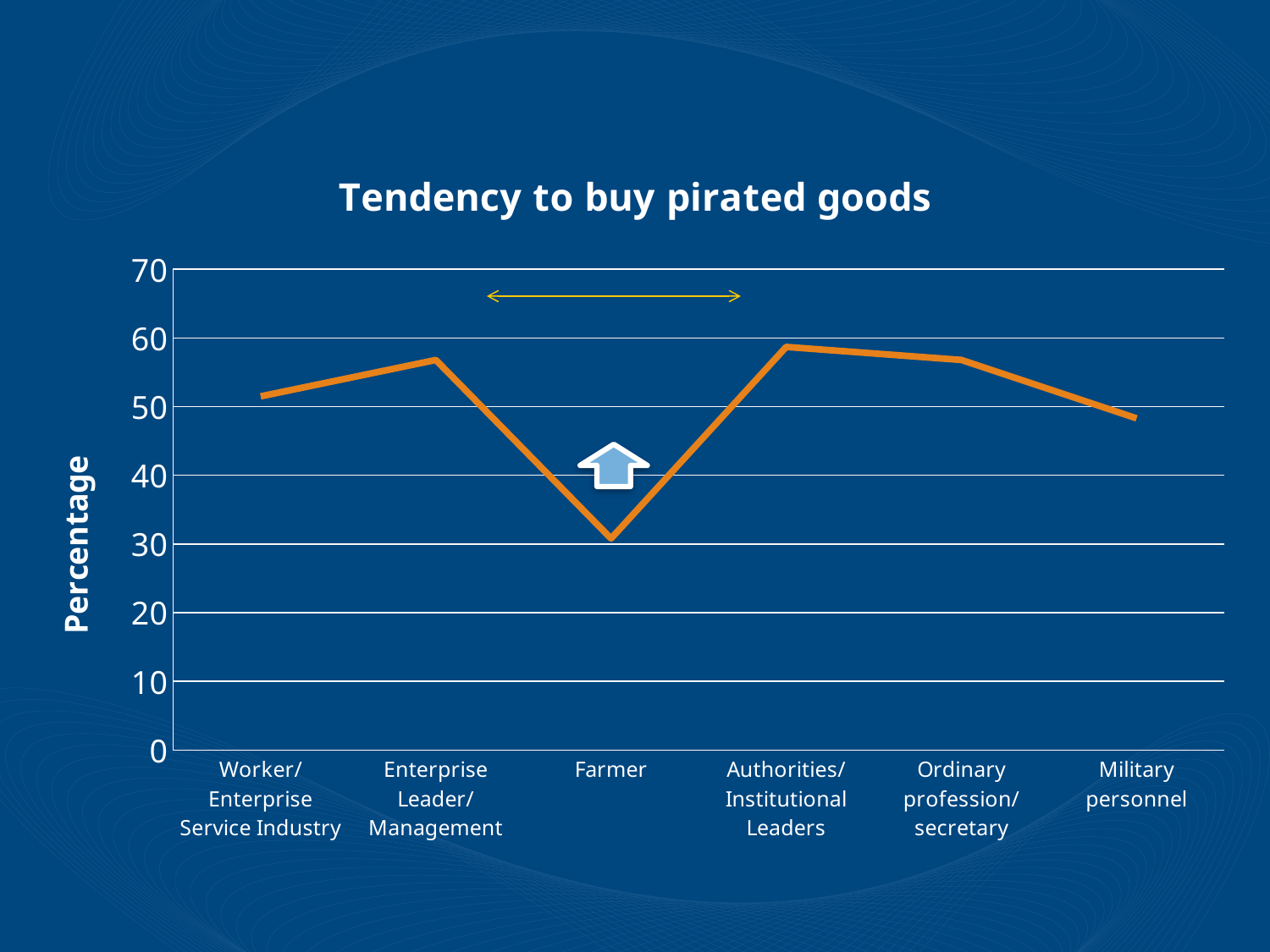
Is the value for Enterprise Leader/Management greater or less than 50? greater Which category has the highest tendency to buy pirated goods? Authorities/Institutional Leaders Which is larger, the value for Enterprise Leader/Management or the value for Military personnel? Enterprise Leader/Management What kind of chart is shown on the slide? line chart What is the title of the chart? Tendency to buy pirated goods How many occupation categories are plotted along the x axis? 6 Which category has the lowest tendency to buy pirated goods? Farmer Does the line rise or fall from Authorities/Institutional Leaders to Military personnel? fall Which is larger, the value for Farmer or the value for Authorities/Institutional Leaders? Authorities/Institutional Leaders Is the value for Farmer greater or less than 40? less What is the label on the y axis? Percentage Is the value for Authorities/Institutional Leaders greater or less than 50? greater